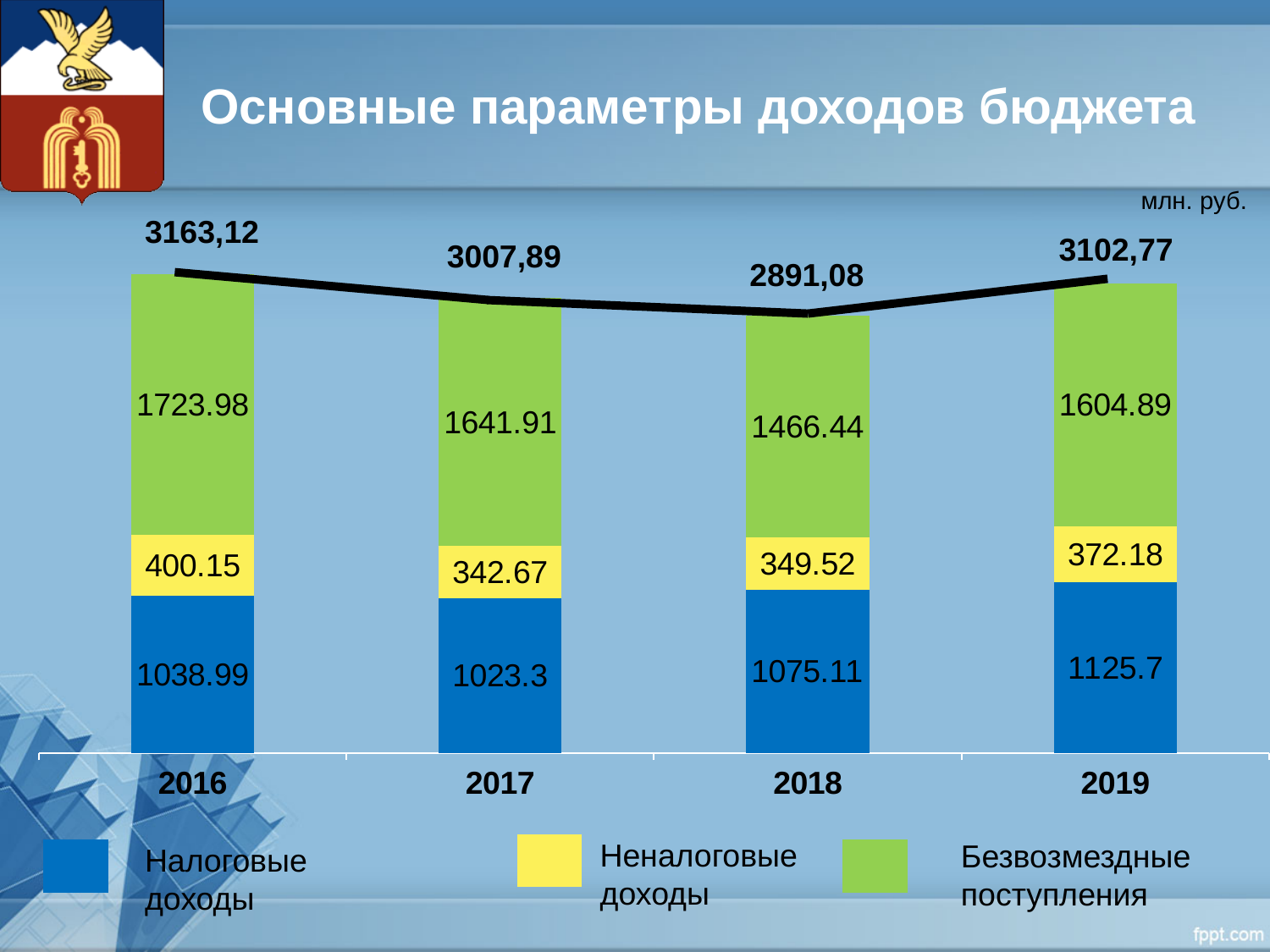
What kind of chart is shown on the slide? Stacked bar chart What is the difference between Безвозмездные поступления in 2016 and 2017? 82.07 Which is larger: Неналоговые доходы in 2016 or in 2018? 2016 How many years are shown on the x axis? 4 What is the value of Налоговые доходы for 2016? 1038.99 How many series does the legend list? 3 What is the value of Неналоговые доходы for 2019? 372.18 What is the value of Безвозмездные поступления for 2018? 1466.44 What unit is indicated in the top right corner of the chart? млн. руб. Which year has the highest value for Налоговые доходы? 2019 Which year has the lowest total shown on the line? 2018 What is the total shown above the bar for 2017? 3007,89